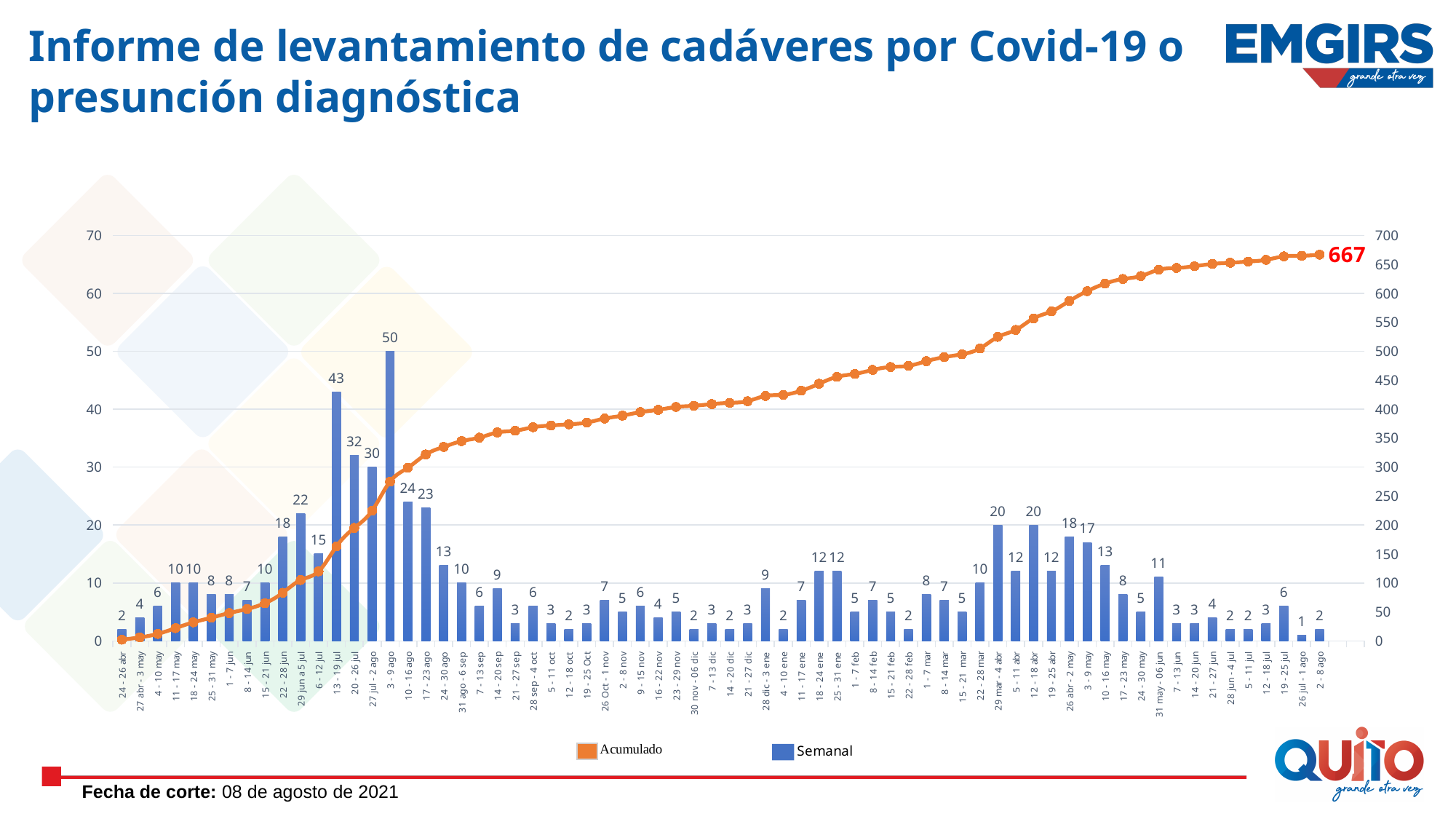
What is the final Acumulado value shown at the end of the line? 667 What colour is the Acumulado series? orange How many series does the legend list? 2 Which week has the lowest Semanal value? 26 jul - 1 ago What is the difference between the Semanal values for 13 - 19 jul and 20 - 26 jul? 11 Which week has the highest Semanal value? 3 - 9 ago Which week has a larger Semanal value, 29 mar - 4 abr or 26 abr - 2 may? 29 mar - 4 abr What is the Semanal value for the week 3 - 9 ago? 50 What kind of chart is used for the Semanal series? bar chart Is the Acumulado value for the week 12 - 18 abr greater or less than 500? greater What is the Semanal value for the week 13 - 19 jul? 43 Does the Acumulado line rise or fall along the x axis? rise